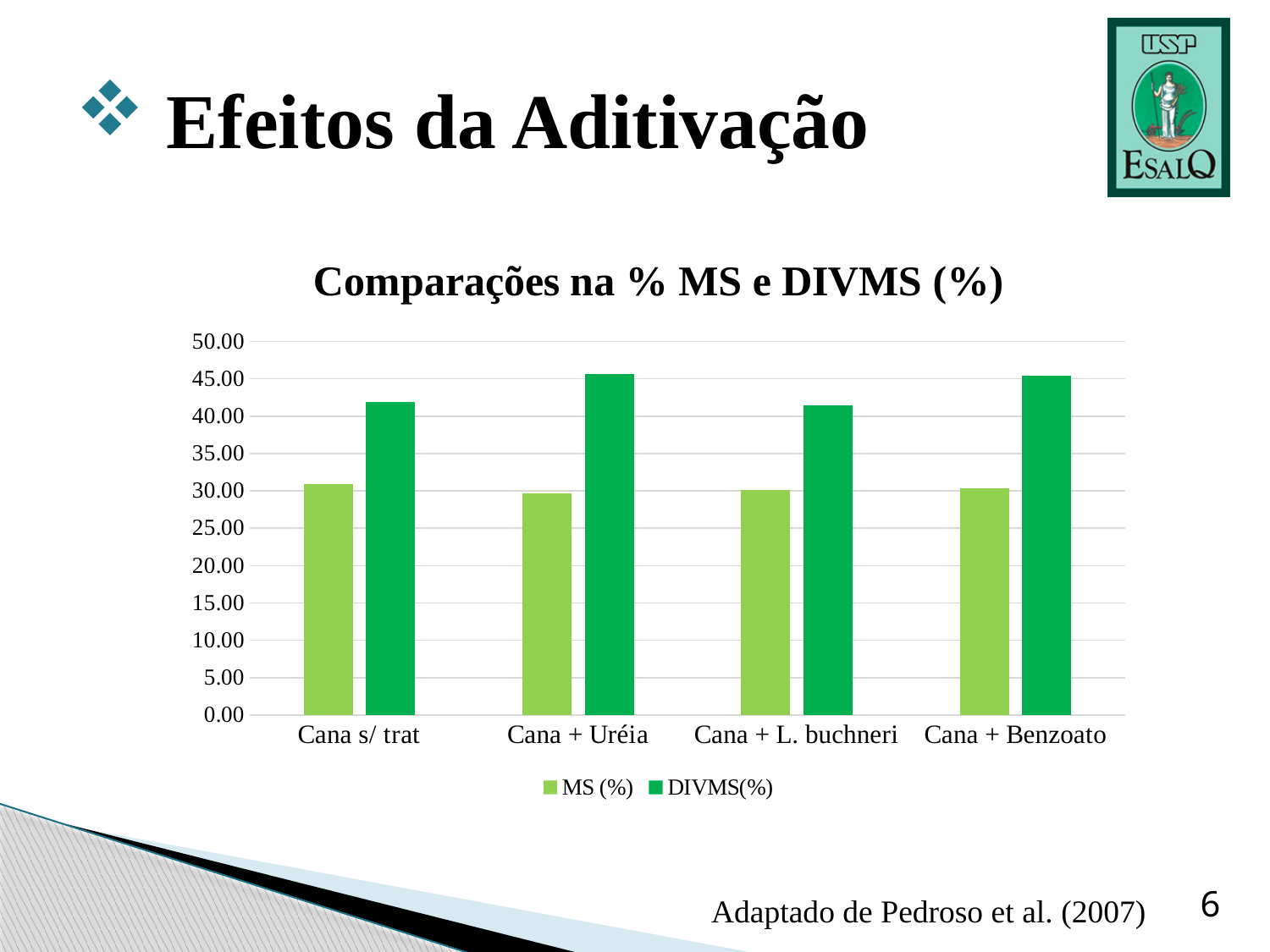
Which has the larger DIVMS(%) value, Cana + Uréia or Cana + L. buchneri? Cana + Uréia Is the DIVMS(%) value for Cana + Uréia greater or less than 40.00? greater What is the title of the chart? Comparações na % MS e DIVMS (%) How many series does the chart legend list? 2 What kind of chart is shown on the slide? bar chart Is the MS (%) value for Cana + Uréia greater or less than 35.00? less Which series is shown in the darker green colour in the chart? DIVMS(%) Which has the larger DIVMS(%) value, Cana s/ trat or Cana + Benzoato? Cana + Benzoato For Cana + Benzoato, which series has the larger value, MS (%) or DIVMS(%)? DIVMS(%) Is the DIVMS(%) value for Cana + L. buchneri greater or less than 45.00? less How many categories are shown on the x axis of the chart? 4